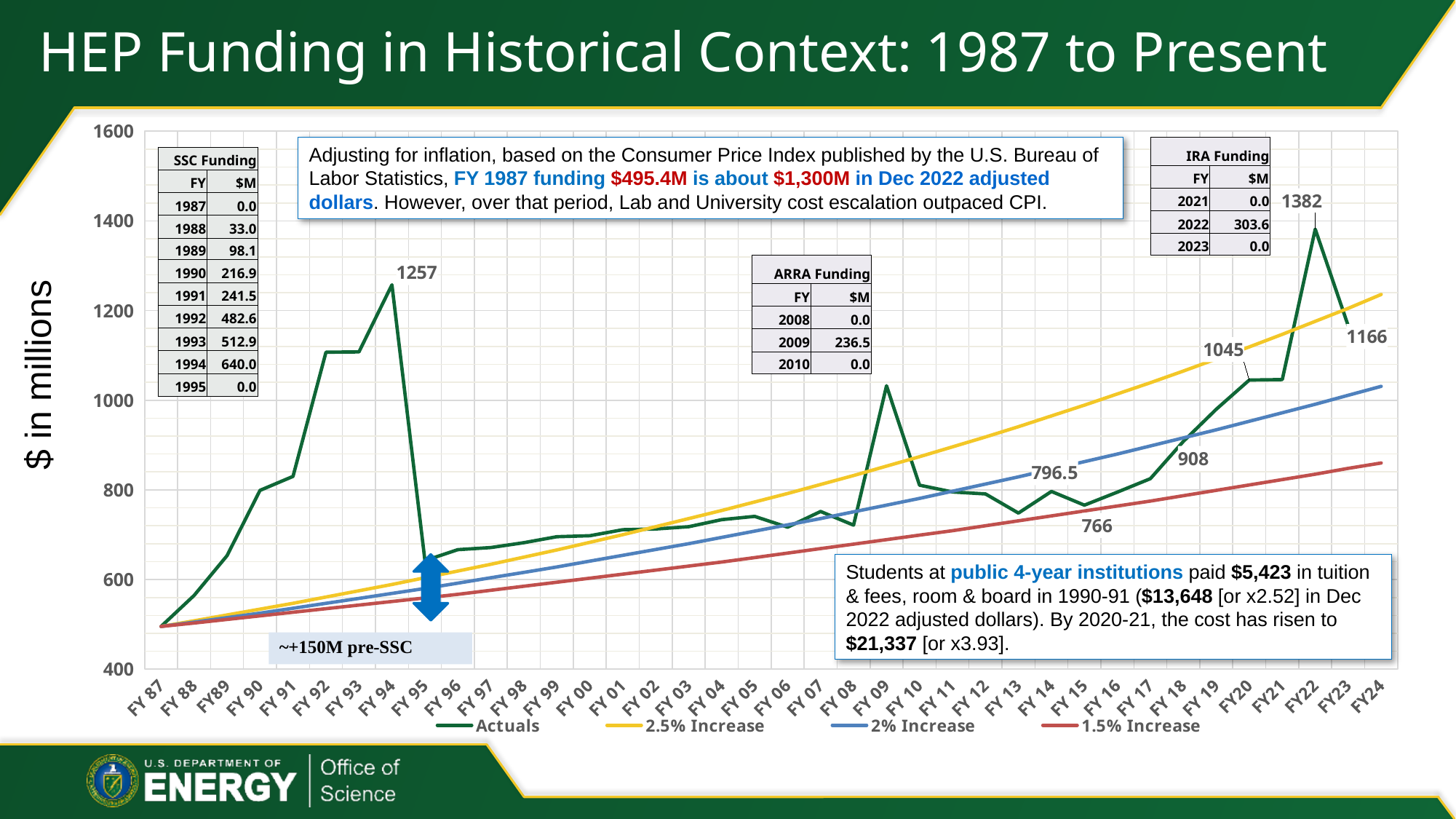
Which is larger, the Actuals value at FY22 or at FY 94? FY22 In which fiscal year does the Actuals series reach its highest value? FY22 What colour is the Actuals series line in the legend? Green What is the labelled value of the Actuals series at FY20? 1045 How many series does the chart legend list? 4 What is the labelled value of the Actuals series at its FY 94 peak? 1257 Does the 2.5% Increase line rise or fall from FY 87 to FY24? Rises What is the difference between the FY22 Actuals value (1382) and the FY 94 Actuals value (1257)? 125 Is the Actuals value at FY 87 greater or less than 600? less What is the difference between the labelled Actuals values 1382 (FY22) and 1166 (FY23)? 216 What kind of chart is shown on the slide? Line chart What is the labelled value of the Actuals series at FY22? 1382